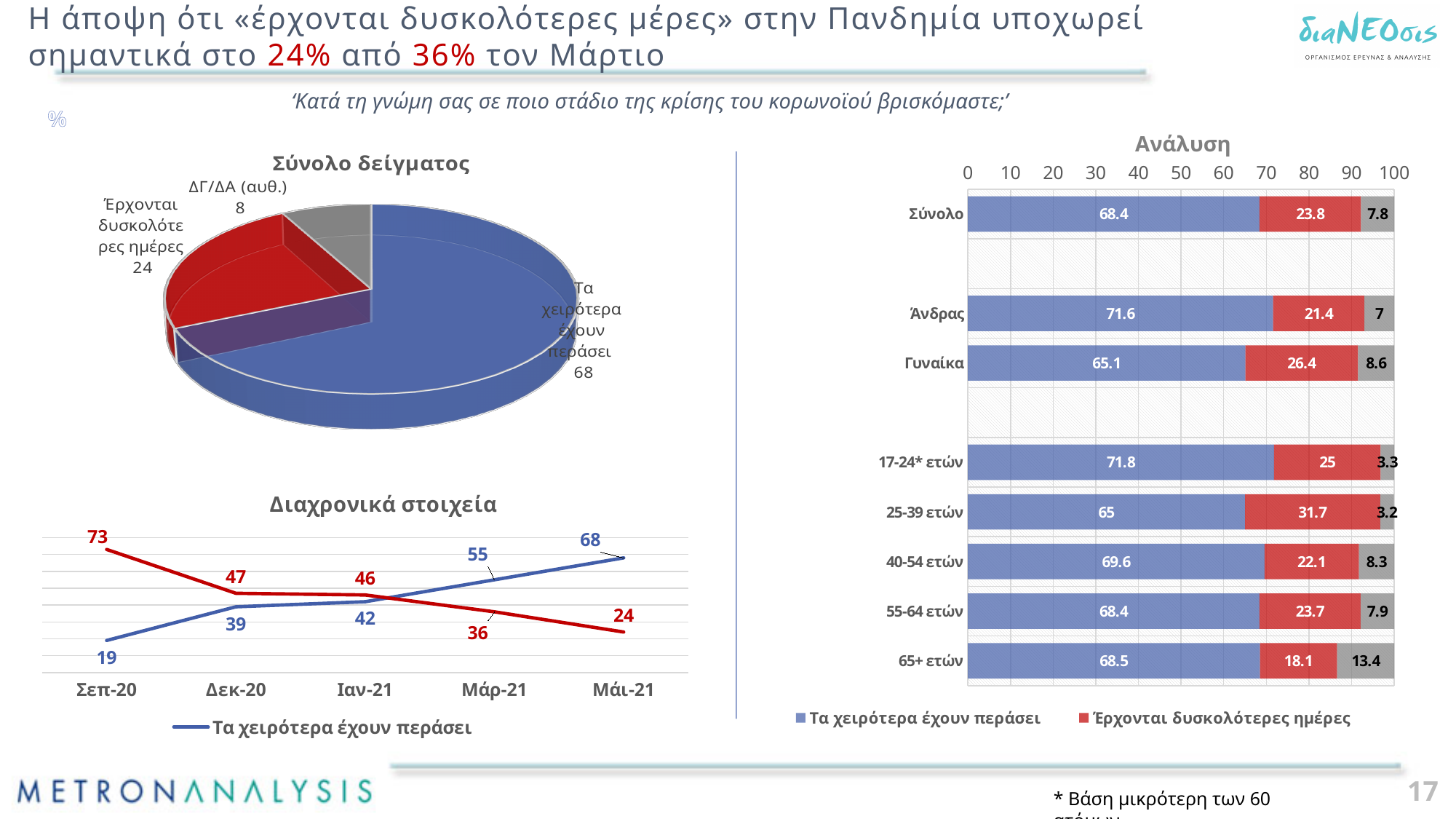
In the 'Ανάλυση' chart, which category has the highest value for 'Τα χειρότερα έχουν περάσει'? 17-24* ετών What type of chart is the 'Ανάλυση' chart? stacked bar chart In the 'Διαχρονικά στοιχεία' chart, what is the value of the blue 'Τα χειρότερα έχουν περάσει' line at Σεπ-20? 19 In the 'Ανάλυση' chart, what is the difference between the 'Τα χειρότερα έχουν περάσει' values for 'Άνδρας' and 'Γυναίκα'? 6.5 In the 'Διαχρονικά στοιχεία' chart, does the blue 'Τα χειρότερα έχουν περάσει' line rise or fall from Σεπ-20 to Μάι-21? rise In the 'Διαχρονικά στοιχεία' chart, what is the difference between the red line's value at Σεπ-20 and at Μάι-21? 49 In the 'Ανάλυση' chart, what is the value of 'Έρχονται δυσκολότερες ημέρες' for '25-39 ετών'? 31.7 In the 'Σύνολο δείγματος' pie chart, which slice is the smallest? ΔΓ/ΔΑ (αυθ.) In the 'Διαχρονικά στοιχεία' chart, what is the value of the red line at Μάρ-21? 36 In the 'Διαχρονικά στοιχεία' chart, how many time points are shown on the x axis? 5 In the 'Σύνολο δείγματος' pie chart, what is the value for 'Τα χειρότερα έχουν περάσει'? 68 In the 'Σύνολο δείγματος' pie chart, how many slices are there? 3